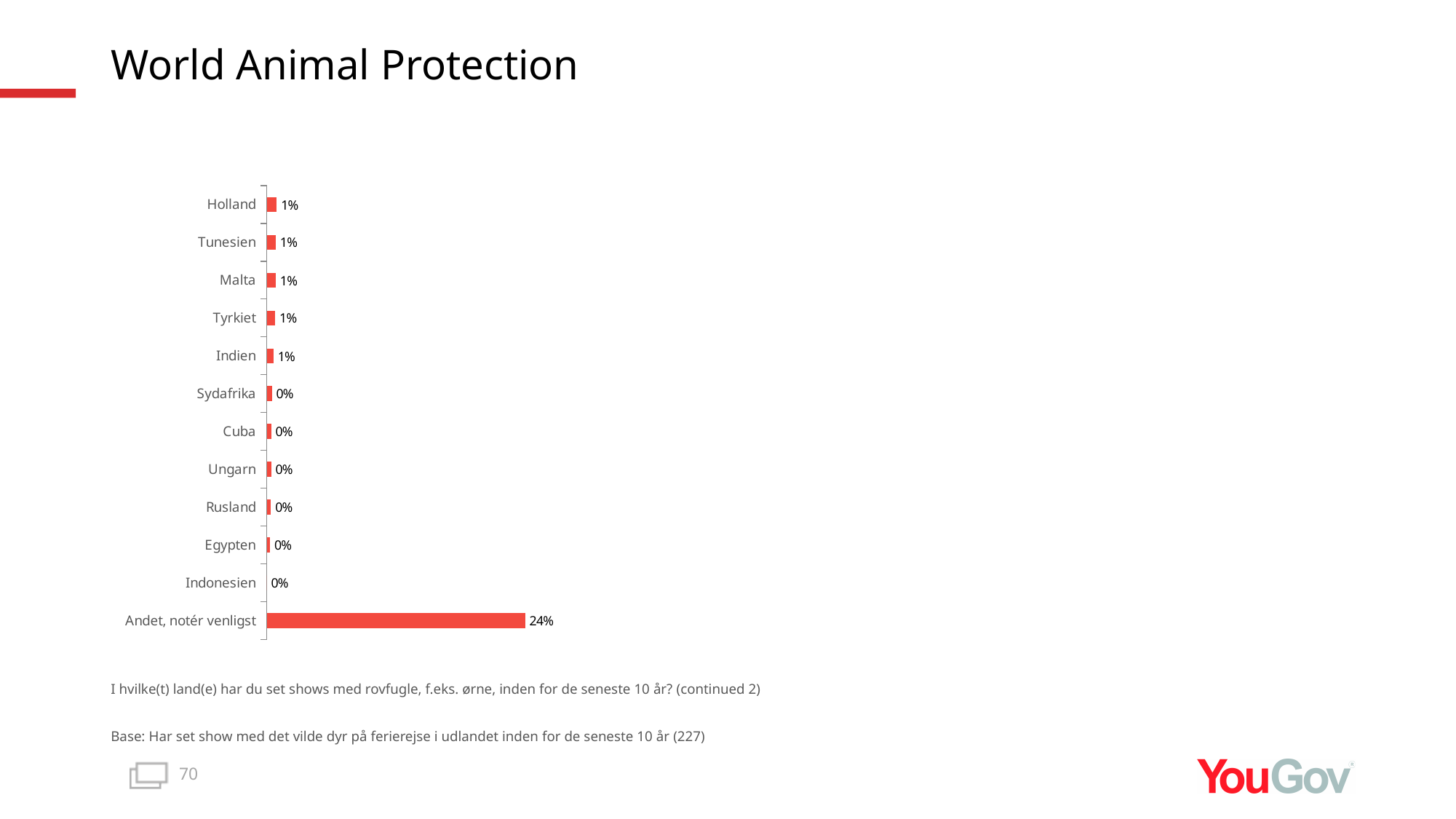
What kind of chart is shown on the slide? Bar chart What is the value for Sydafrika? 0% What is the difference between the values for Andet, notér venligst and Malta? 23% What is the value for Andet, notér venligst? 24% Which is larger, the value for Indien or the value for Cuba? Indien What is the value for Tyrkiet? 1% How many categories are shown in the chart? 12 What is the value for Indonesien? 0% Which category has the highest value? Andet, notér venligst How many categories have a value of 1%? 5 What colour are the bars in the chart? Red What is the value for Holland? 1%